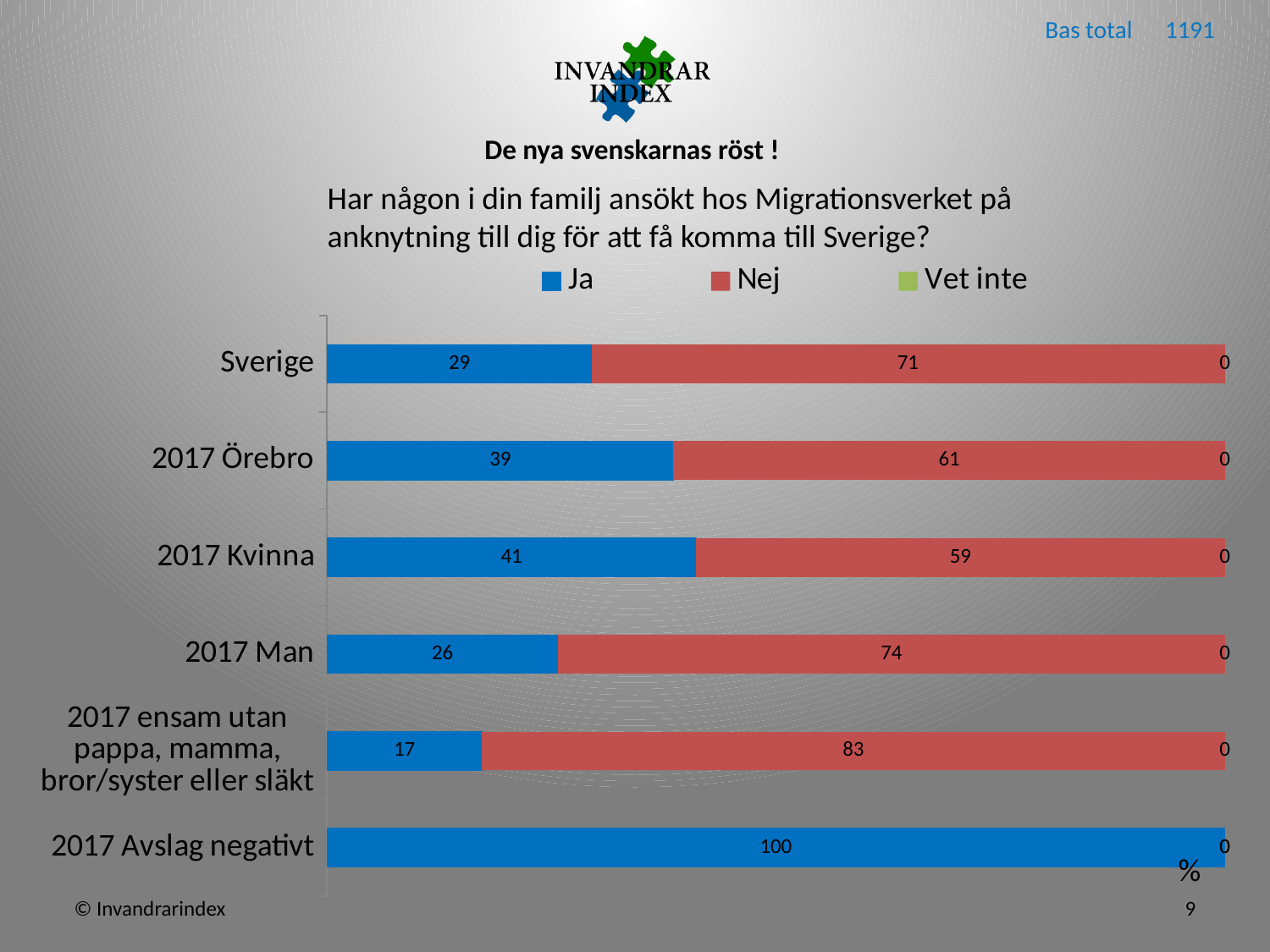
What kind of chart is shown on the slide? Stacked bar chart What is the difference between the "Nej" values for 2017 Man and 2017 Kvinna? 15 What is the total of the stacked bar for 2017 Örebro? 100 How many categories are shown on the chart? 6 How many series does the legend list? 3 What is the value for "Nej" for 2017 Man? 74 Which category has the lowest value for "Nej"? 2017 Avslag negativt Which is larger, the "Ja" value for 2017 Kvinna or for 2017 Man? 2017 Kvinna What is the value for "Ja" for Sverige? 29 What is the value for "Ja" for 2017 Örebro? 39 What is the value for "Nej" for 2017 ensam utan pappa, mamma, bror/syster eller släkt? 83 Which category has the highest value for "Ja"? 2017 Avslag negativt